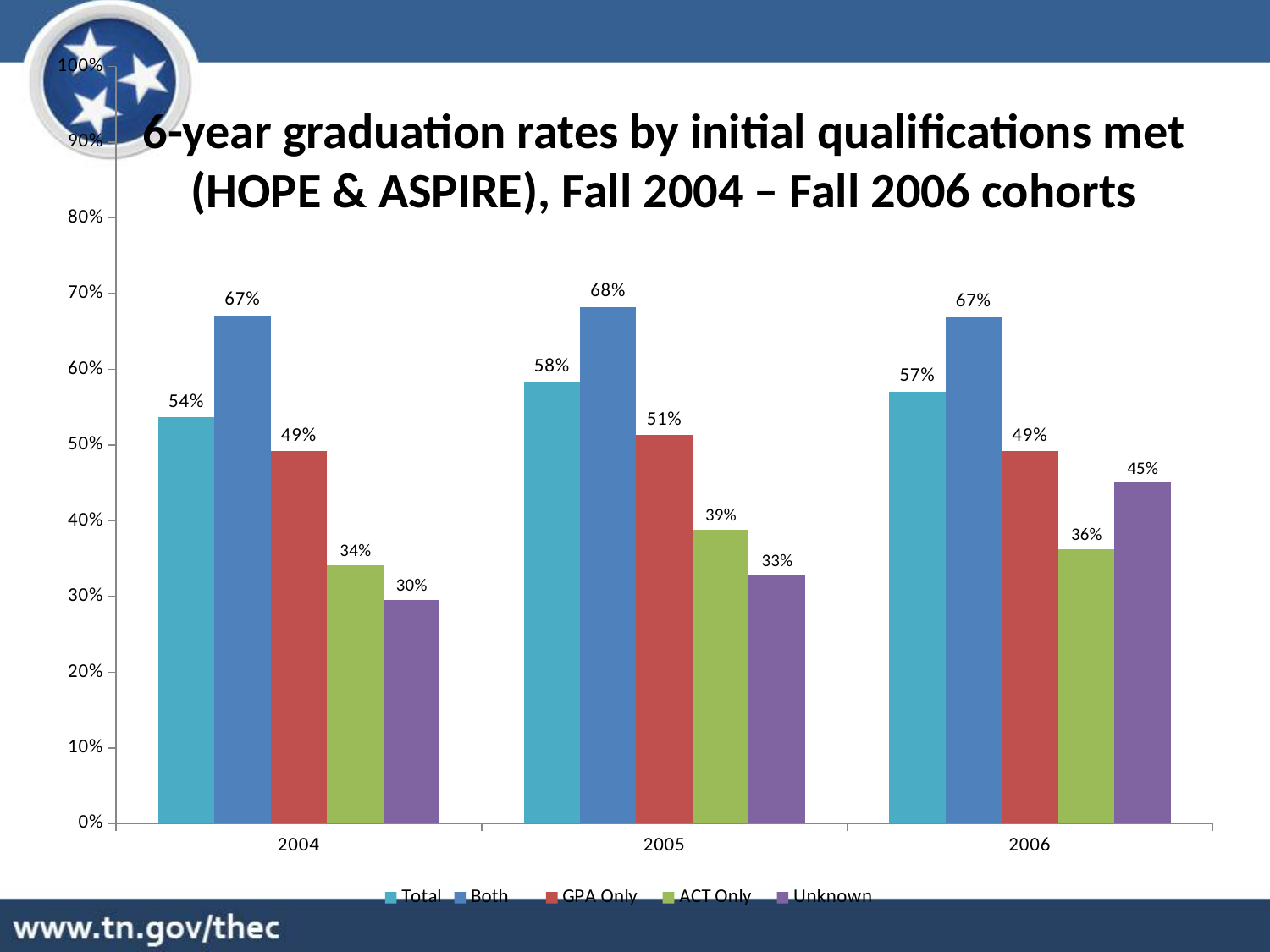
What is the Total graduation rate for the 2004 cohort? 54% Does the Unknown series rise or fall from 2004 to 2006? Rise What colour are the bars for the GPA Only series? Red Which series has the lowest graduation rate in the 2005 cohort? Unknown What is the graduation rate for the Unknown series in the 2006 cohort? 45% What is the 6-year graduation rate for the Both series in the 2005 cohort? 68% What kind of chart is shown on the slide? Bar chart Which series has the highest graduation rate in the 2004 cohort? Both How many series does the legend list? 5 How many cohort years are shown on the x axis? 3 Which is larger: the ACT Only rate in 2005 or the ACT Only rate in 2006? 2005 What is the difference between the Both and GPA Only graduation rates in the 2006 cohort? 18%